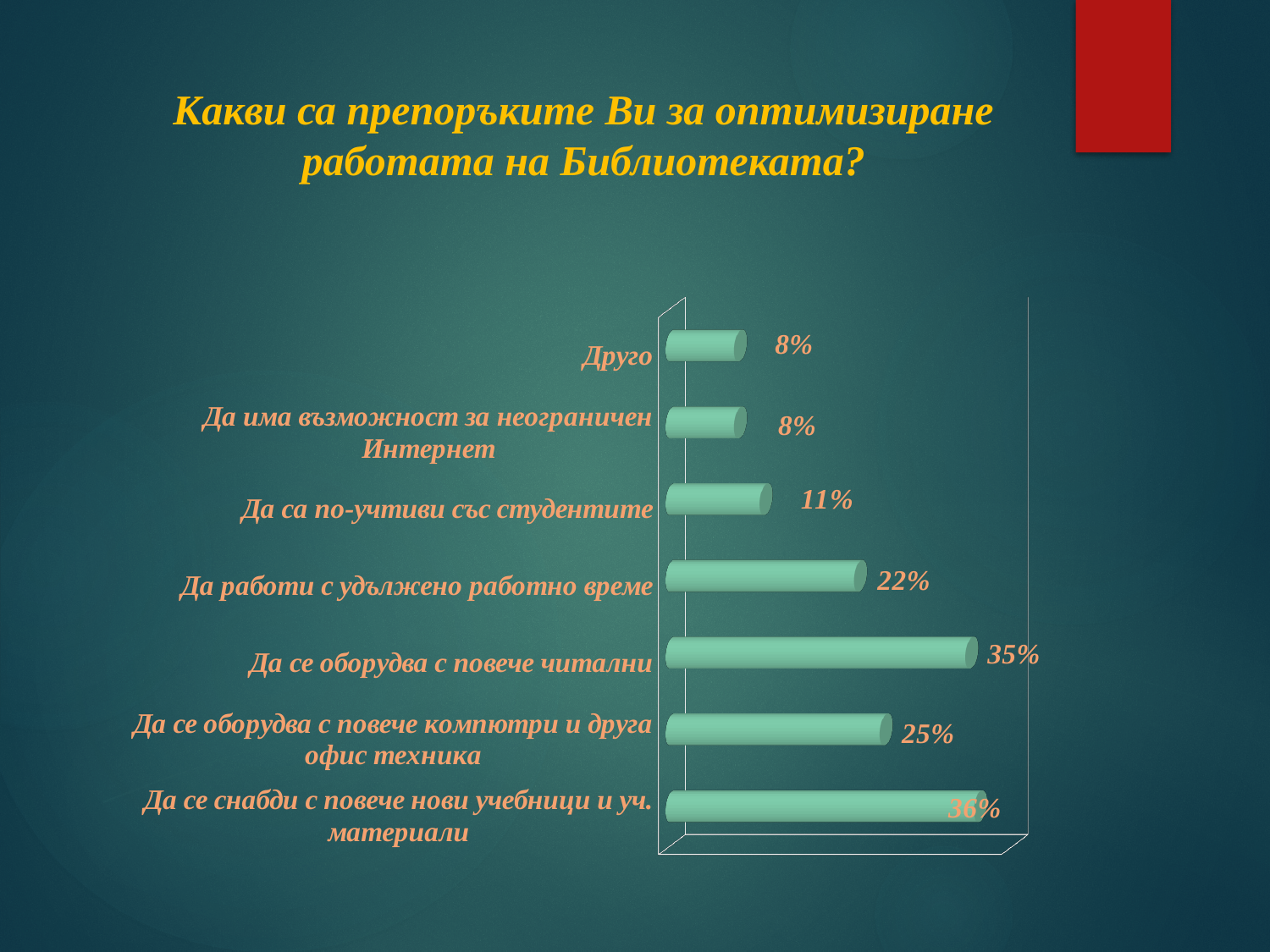
What is the value for "Да се оборудва с повече читални"? 35% What is the value for "Да се снабди с повече нови учебници и уч. материали"? 36% Which is larger: the value for "Да се оборудва с повече компютри и друга офис техника" or the value for "Да работи с удължено работно време"? Да се оборудва с повече компютри и друга офис техника How many categories does the chart show? 7 What is the value for "Да работи с удължено работно време"? 22% What is the value for "Да са по-учтиви със студентите"? 11% What kind of chart is shown on the slide? bar chart What is the title of the slide containing the chart? Какви са препоръките Ви за оптимизиране работата на Библиотеката? What is the difference between the values for "Да се оборудва с повече читални" and "Да работи с удължено работно време"? 13% Which category has the highest value? Да се снабди с повече нови учебници и уч. материали What is the difference between the values for "Да са по-учтиви със студентите" and "Да има възможност за неограничен Интернет"? 3% What is the value for "Друго"? 8%